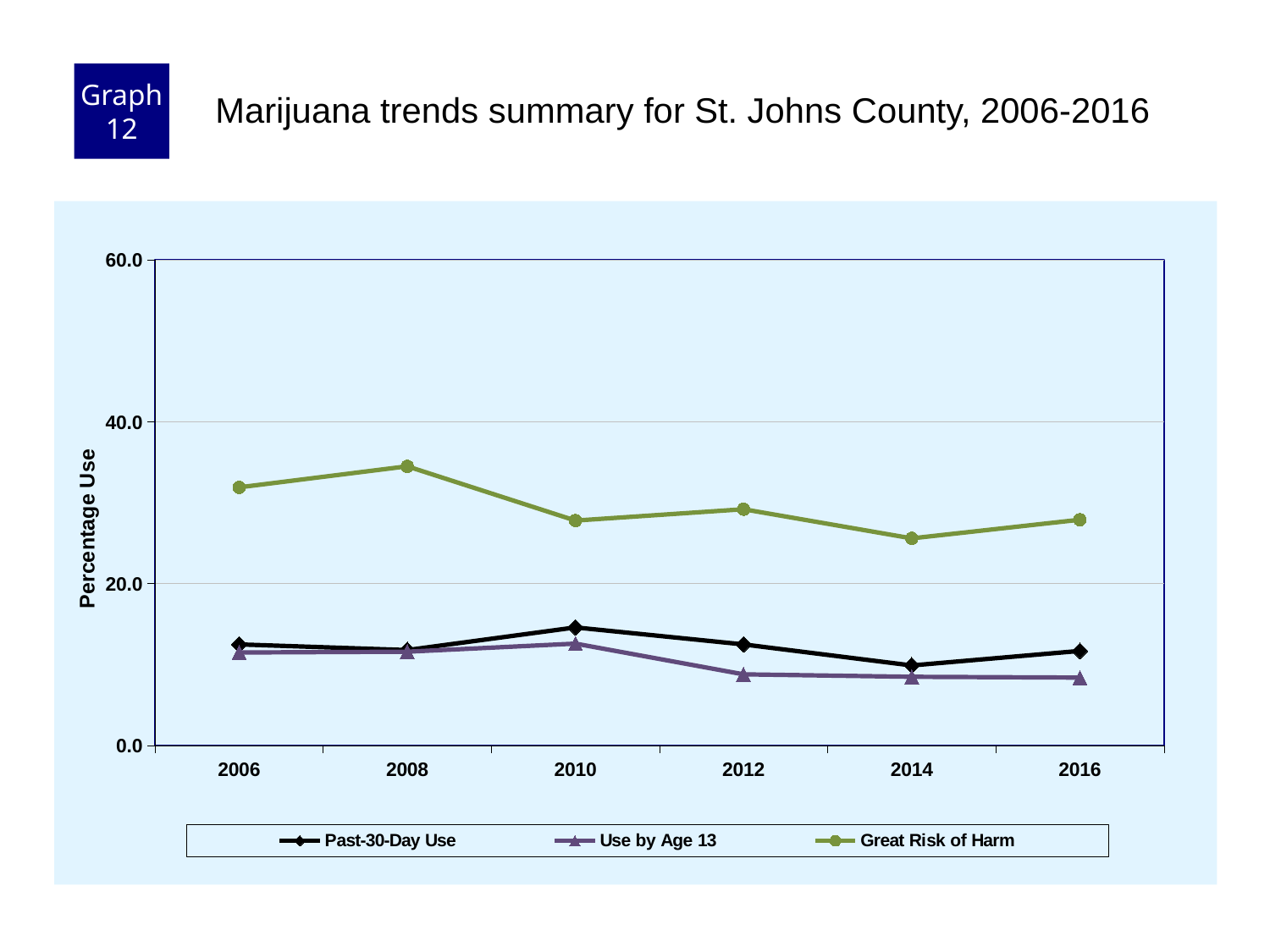
In which year is the Great Risk of Harm series at its lowest? 2014 Does the Great Risk of Harm series rise or fall from 2008 to 2014? fall Which series has the larger value in 2012, Past-30-Day Use or Use by Age 13? Past-30-Day Use How many years are plotted along the x axis? 6 In which year is the Past-30-Day Use series at its highest? 2010 What kind of chart is shown on the slide? line chart How many series does the legend list? 3 Is the value for Past-30-Day Use in 2010 greater or less than 20.0? less What is the label on the y axis? Percentage Use In which year is the Past-30-Day Use series at its lowest? 2014 Is the value for Great Risk of Harm in 2008 greater or less than 40.0? less In which year is the Great Risk of Harm series at its highest? 2008